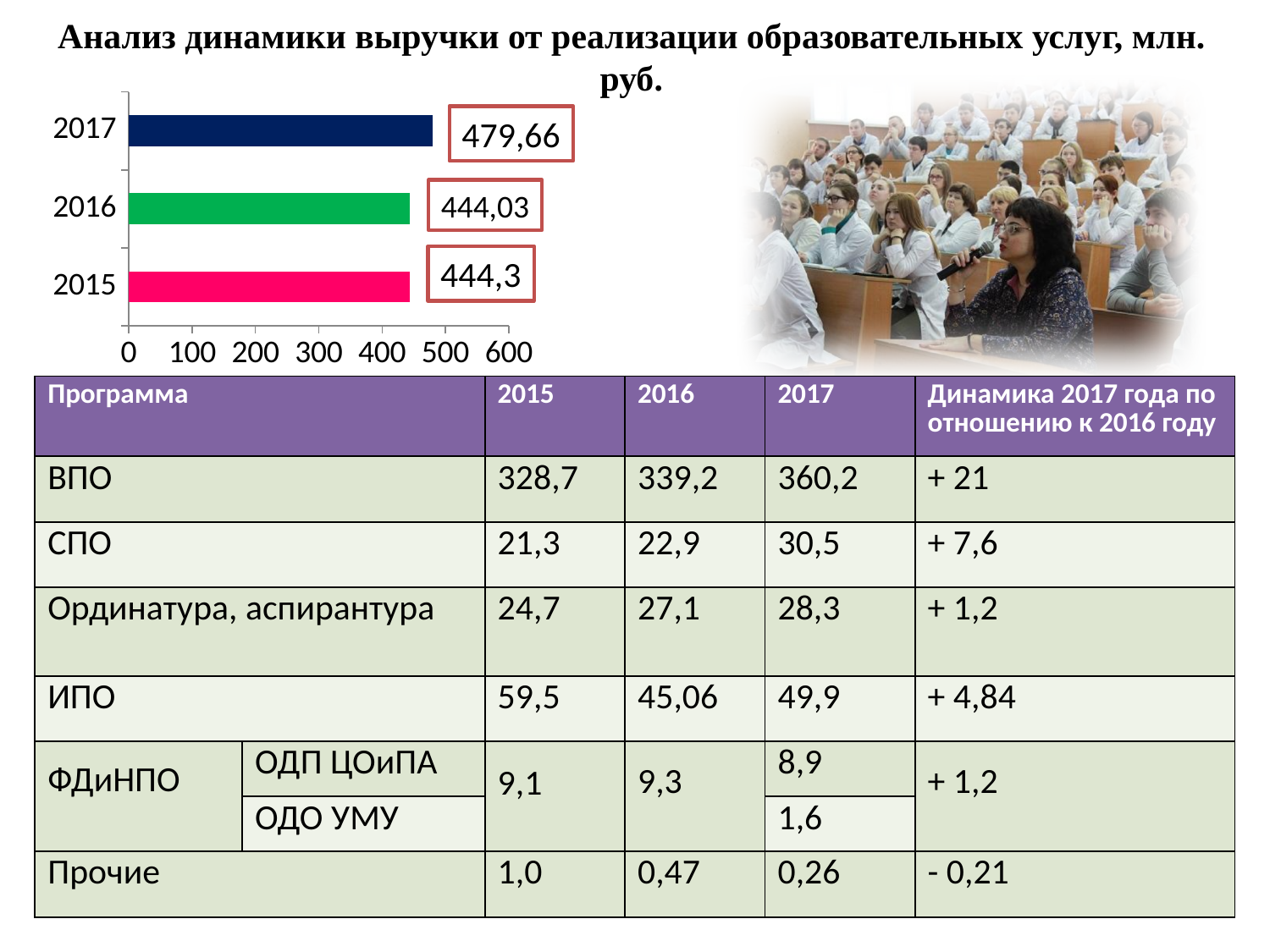
How many years (bars) are shown on the bar chart? 3 What is the difference between the 2017 and 2015 values on the bar chart? 35,36 Which year has the highest value on the bar chart? 2017 What is the value shown for 2015 on the bar chart? 444,3 Which is larger on the bar chart, the value for 2017 or the value for 2015? 2017 What is the value shown for 2017 on the bar chart? 479,66 What is the value shown for 2016 on the bar chart? 444,03 What kind of chart is shown on the slide? bar chart Is the value for 2017 on the bar chart greater or less than 400? greater What colour is the bar for 2017 on the chart? dark blue What is the difference between the 2017 and 2016 values on the bar chart? 35,63 Is the value for 2015 on the bar chart greater or less than 500? less